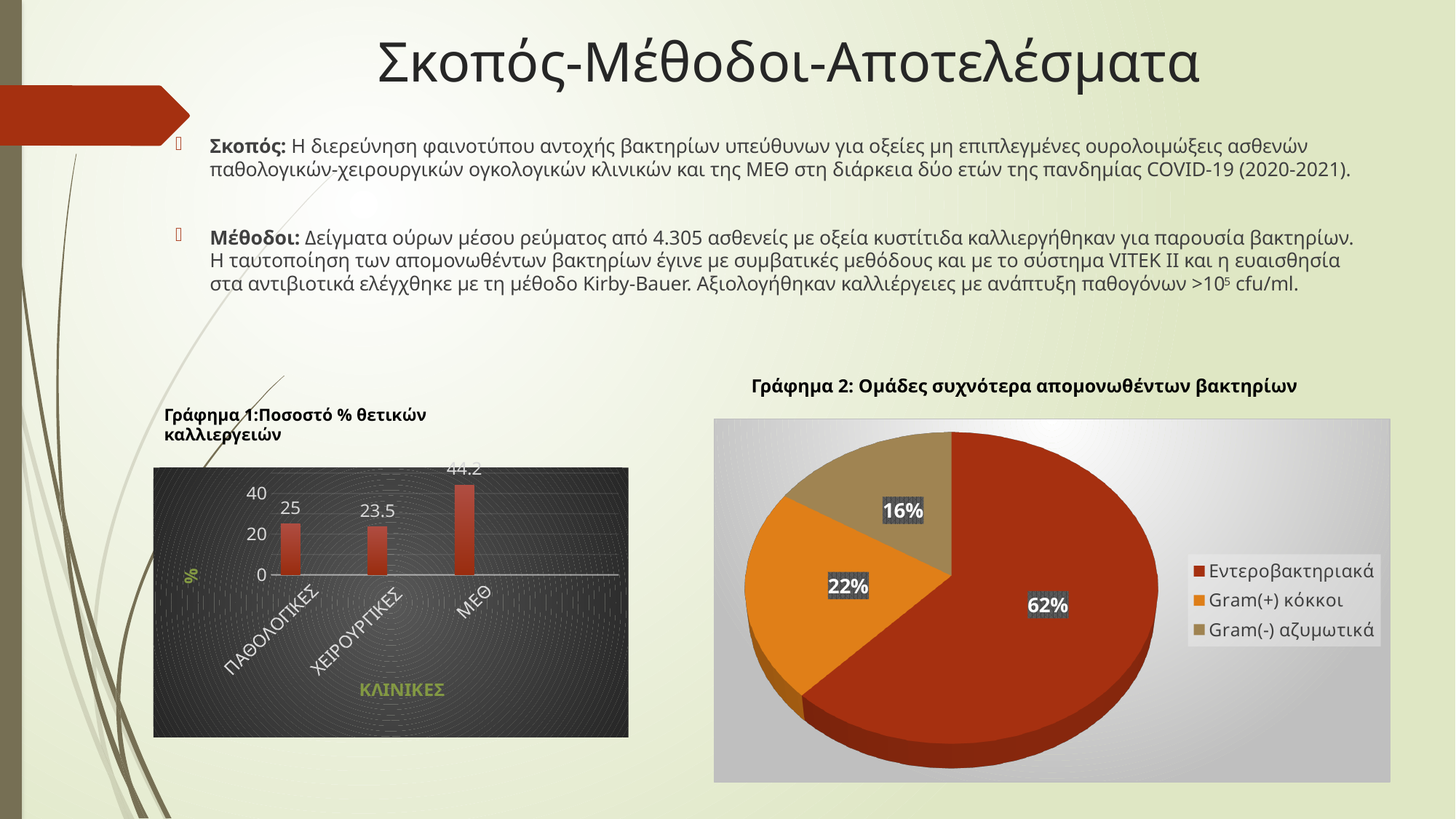
In Γράφημα 1 (Ποσοστό % θετικών καλλιεργειών), what is the difference between the values for ΜΕΘ and ΠΑΘΟΛΟΓΙΚΕΣ? 19.2 In Γράφημα 1 (Ποσοστό % θετικών καλλιεργειών), how many categories are shown on the x axis? 3 In Γράφημα 1 (Ποσοστό % θετικών καλλιεργειών), what is the value for ΜΕΘ? 44.2 In Γράφημα 2 (Ομάδες συχνότερα απομονωθέντων βακτηρίων), which group has the largest slice? Εντεροβακτηριακά In Γράφημα 2 (Ομάδες συχνότερα απομονωθέντων βακτηρίων), what share of the pie is Gram(+) κόκκοι? 22% In Γράφημα 2 (Ομάδες συχνότερα απομονωθέντων βακτηρίων), what share of the pie is Gram(-) αζυμωτικά? 16% In Γράφημα 1 (Ποσοστό % θετικών καλλιεργειών), which category has the lowest value? ΧΕΙΡΟΥΡΓΙΚΕΣ In Γράφημα 2 (Ομάδες συχνότερα απομονωθέντων βακτηρίων), how many entries does the legend list? 3 In Γράφημα 1 (Ποσοστό % θετικών καλλιεργειών), what is the value for ΧΕΙΡΟΥΡΓΙΚΕΣ? 23.5 What kind of chart is Γράφημα 1 (Ποσοστό % θετικών καλλιεργειών)? bar chart What kind of chart is Γράφημα 2 (Ομάδες συχνότερα απομονωθέντων βακτηρίων)? pie chart In Γράφημα 1 (Ποσοστό % θετικών καλλιεργειών), which category has the highest value? ΜΕΘ